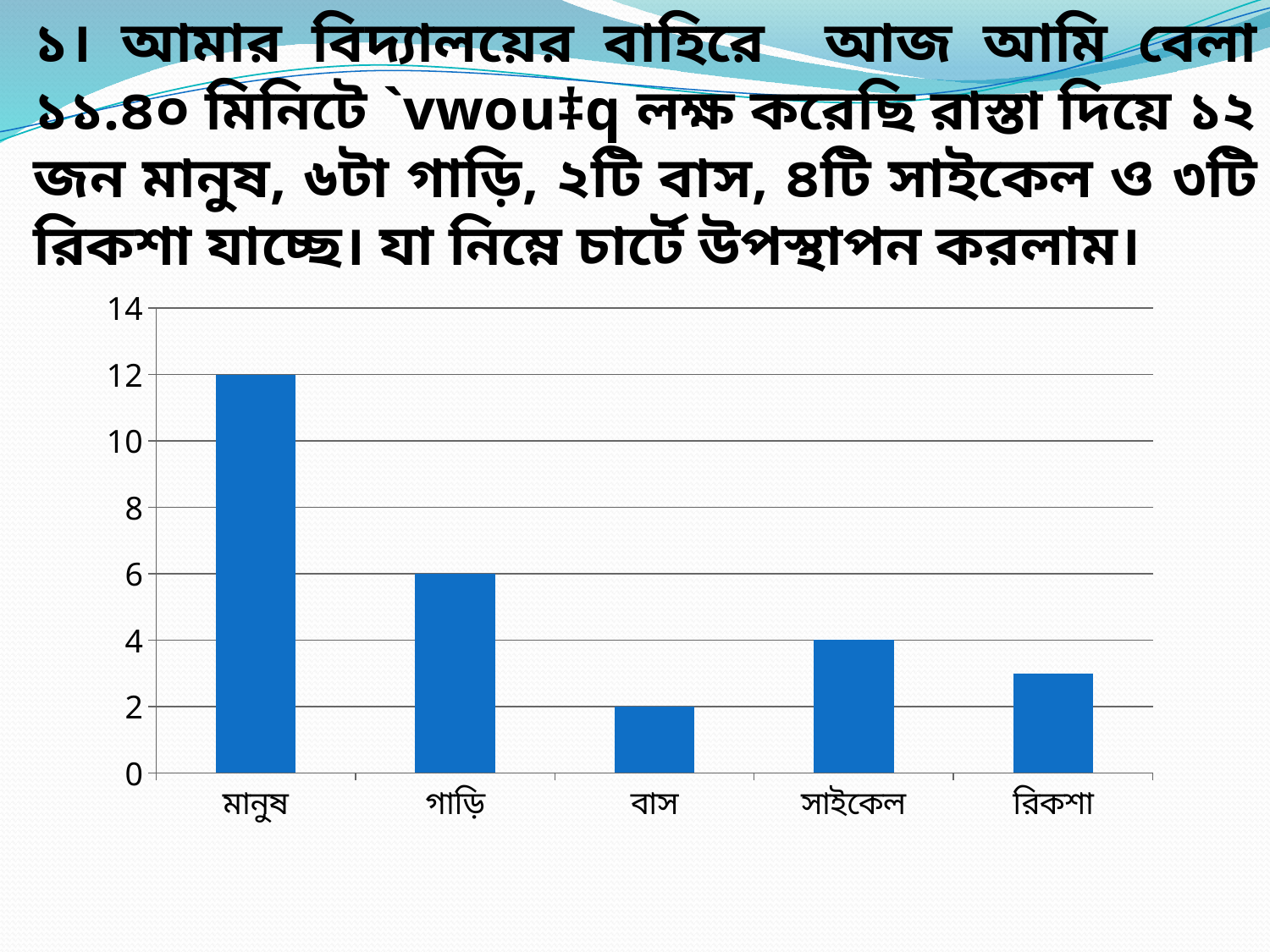
What is the highest value shown on the y axis of the chart? 14 Which category has the lowest value in the chart? বাস How many categories are shown on the x axis of the chart? 5 What is the value for মানুষ in the chart? 12 Which category has the highest value in the chart? মানুষ What is the value for বাস in the chart? 2 What is the value for সাইকেল in the chart? 4 Is the value for রিকশা greater or less than 4? less Which is larger, the value for সাইকেল or the value for রিকশা? সাইকেল What is the difference between the values for মানুষ and গাড়ি? 6 What is the value for গাড়ি in the chart? 6 What type of chart is shown on the slide? bar chart